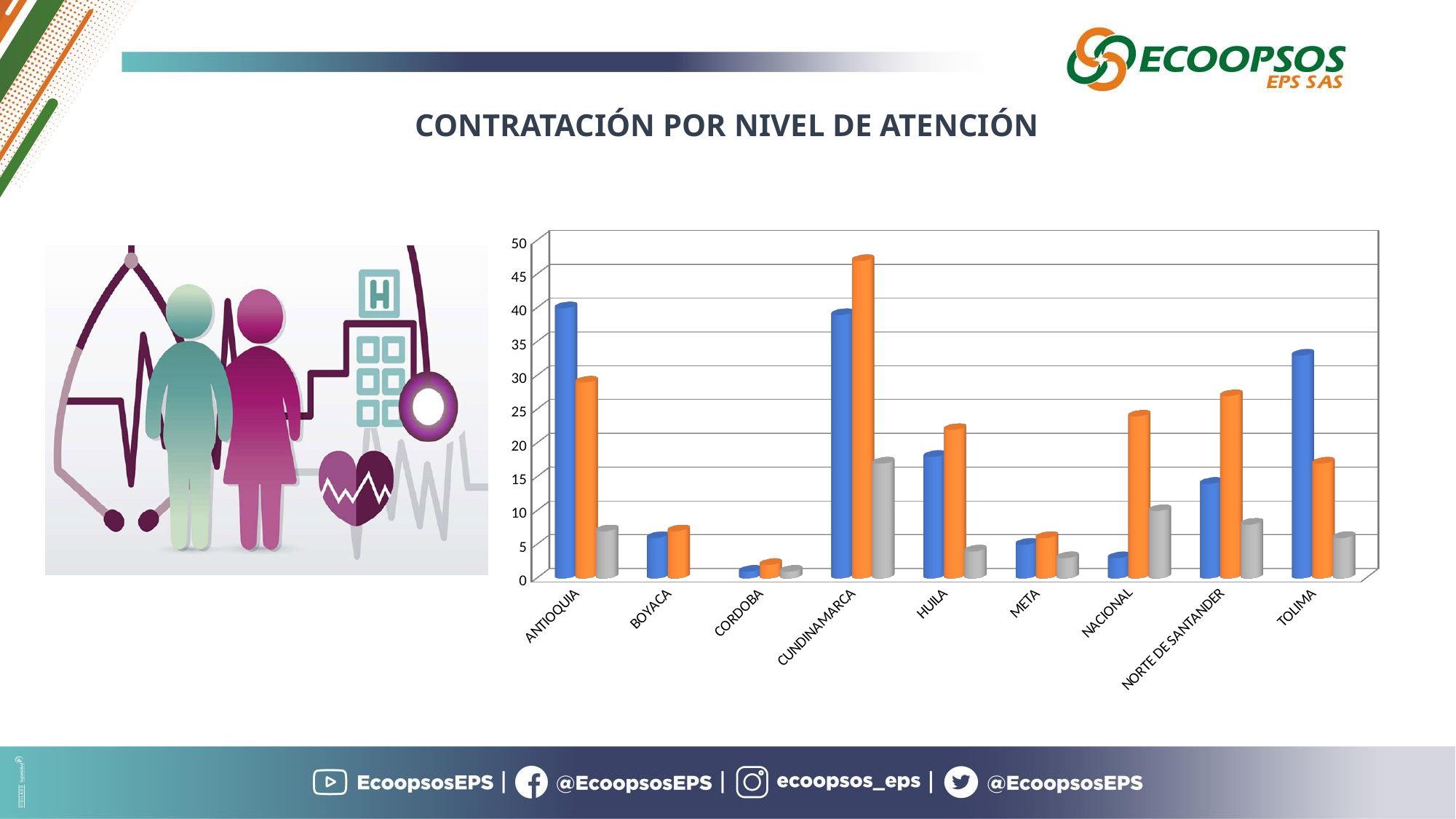
Which category has the smallest bars overall? CORDOBA What kind of chart is shown on the slide? Bar chart For ANTIOQUIA, which is larger: the blue bar or the orange bar? The blue bar Is the orange bar for NORTE DE SANTANDER greater or less than 20? greater Which category has the tallest orange bar? CUNDINAMARCA How many bars are plotted for each category in the chart? 3 How many categories are shown on the x axis of the chart? 9 What is the title shown above the chart? CONTRATACIÓN POR NIVEL DE ATENCIÓN Is the orange bar for CUNDINAMARCA greater or less than 45? greater Is the blue bar for TOLIMA greater or less than 30? greater For CUNDINAMARCA, which is larger: the blue bar or the orange bar? The orange bar